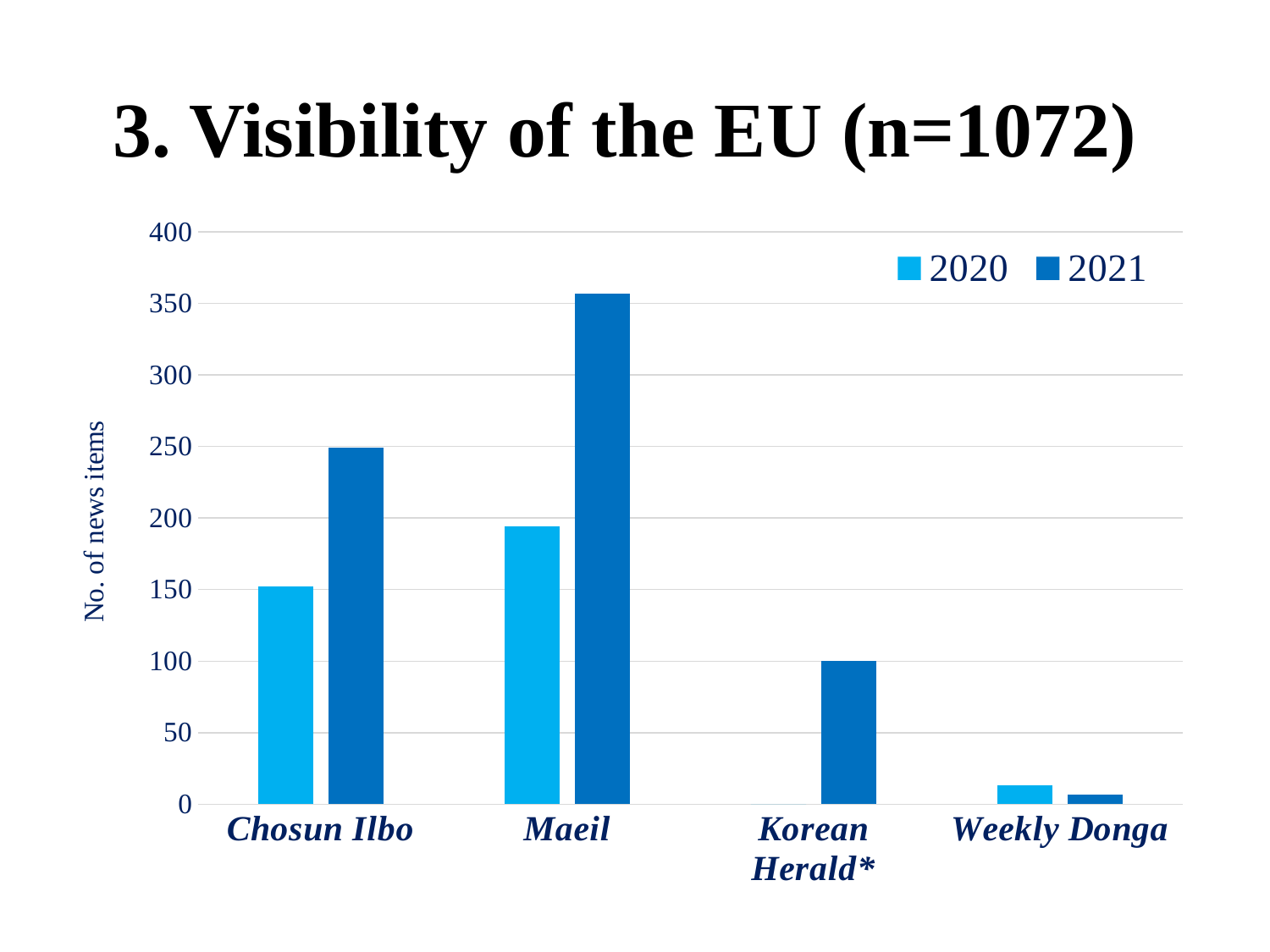
Is the 2021 value for Maeil greater or less than 300? greater What is the label on the vertical axis? No. of news items Is the 2020 value for Chosun Ilbo greater or less than 200? less Which outlet has the highest number of news items in 2020? Maeil Is the 2020 value for Maeil greater or less than 150? greater What kind of chart is shown on the slide? bar chart For Chosun Ilbo, which year has more news items, 2020 or 2021? 2021 How many series does the legend list? 2 Which outlet has the lowest number of news items in 2021? Weekly Donga For Weekly Donga, which year has more news items, 2020 or 2021? 2020 Which outlet has the highest number of news items in 2021? Maeil How many news outlets are shown on the x axis? 4